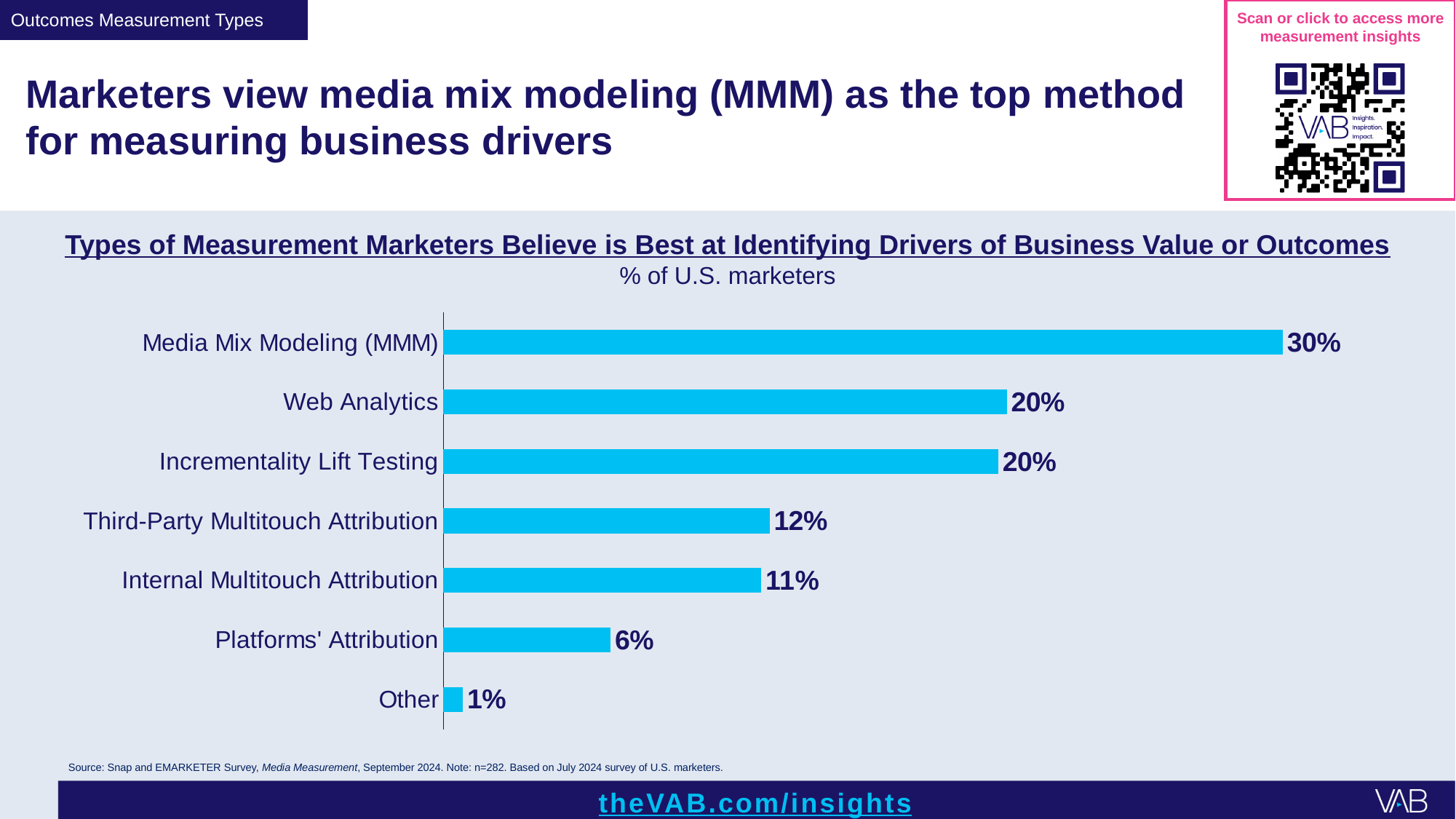
What is the value shown for Platforms' Attribution? 6% Which measurement type has the highest percentage in the chart? Media Mix Modeling (MMM) What is the value shown for Third-Party Multitouch Attribution? 12% What is the title of the chart? Types of Measurement Marketers Believe is Best at Identifying Drivers of Business Value or Outcomes Which measurement type has the lowest percentage in the chart? Other What percentage of U.S. marketers believe Media Mix Modeling (MMM) is best at identifying drivers of business value? 30% What is the subtitle under the chart title describing the unit of measurement? % of U.S. marketers What kind of chart is shown on the slide? Bar chart Which is larger, the value for Incrementality Lift Testing or the value for Internal Multitouch Attribution? Incrementality Lift Testing What is the difference in percentage points between Media Mix Modeling (MMM) and Web Analytics? 10 percentage points How many measurement types are shown in the chart? 7 What is the difference between Third-Party Multitouch Attribution and Internal Multitouch Attribution? 1 percentage point